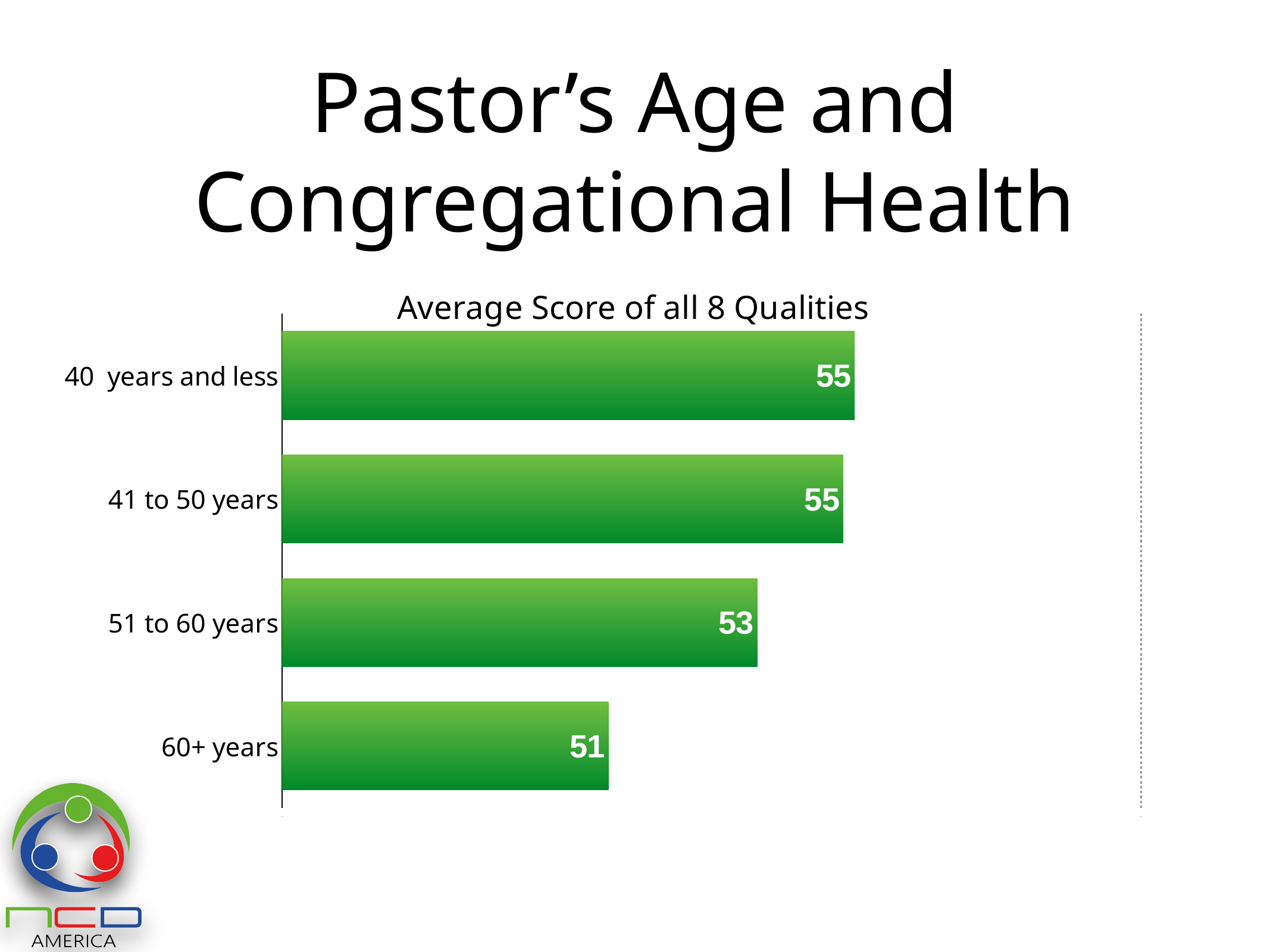
Which age group has the lowest average score? 60+ years What is the difference between the average score for 40 years and less and 60+ years? 4 What is the average score for pastors aged 60+ years? 51 What is the title of the chart? Average Score of all 8 Qualities Do the average scores rise or fall as the pastor's age group increases from top to bottom? Fall What is the difference between the average score for 51 to 60 years and 60+ years? 2 How many age groups are shown in the chart? 4 What is the average score for pastors aged 40 years and less? 55 What is the average score for pastors aged 41 to 50 years? 55 Which is larger, the average score for 41 to 50 years or for 51 to 60 years? 41 to 50 years What is the average score for pastors aged 51 to 60 years? 53 What kind of chart is shown on the slide? Bar chart